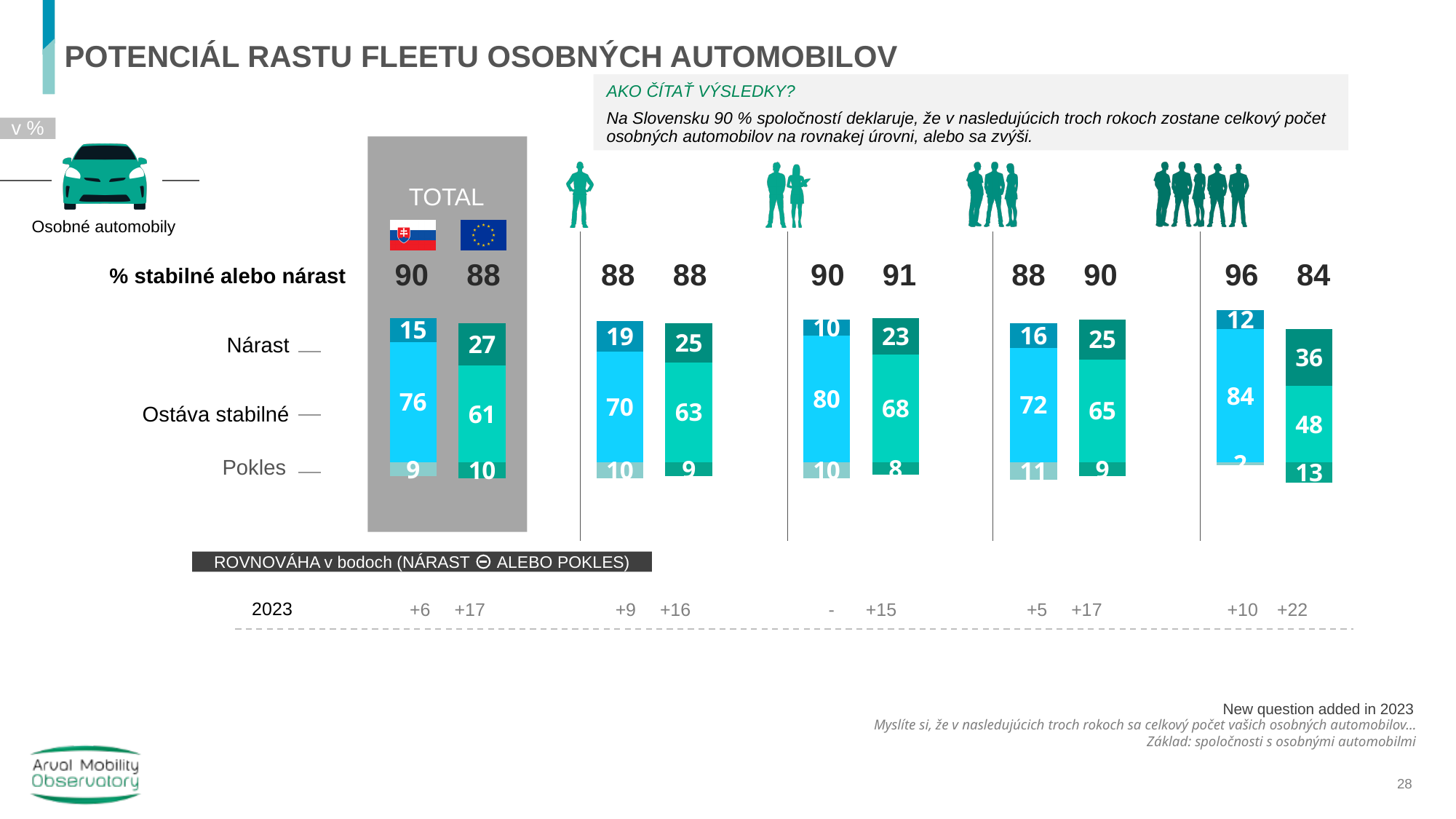
What is the Slovak '% stabilné alebo nárast' value in the TOTAL group? 90 In the rightmost group of bars, what is the EU value for Nárast? 36 How many groups of bar pairs (including TOTAL) are shown on the slide? 5 In the TOTAL group, what is the EU value for Ostáva stabilné? 61 In the TOTAL group, which has the larger Ostáva stabilné value, Slovakia or the EU? Slovakia What kind of chart is used to show Nárast, Ostáva stabilné and Pokles? Stacked bar chart In the rightmost group of bars, what is the Slovak '% stabilné alebo nárast' value? 96 In the TOTAL group, what is the Slovak value for Nárast? 15 What is the EU 'ROVNOVÁHA v bodoch' value for the TOTAL group? +17 What label is written at the top of the grey shaded box? TOTAL In the TOTAL group, what is the difference between the EU and Slovak Nárast values? 12 What is the total of the Slovak stacked bar in the TOTAL group (Nárast + Ostáva stabilné + Pokles)? 100